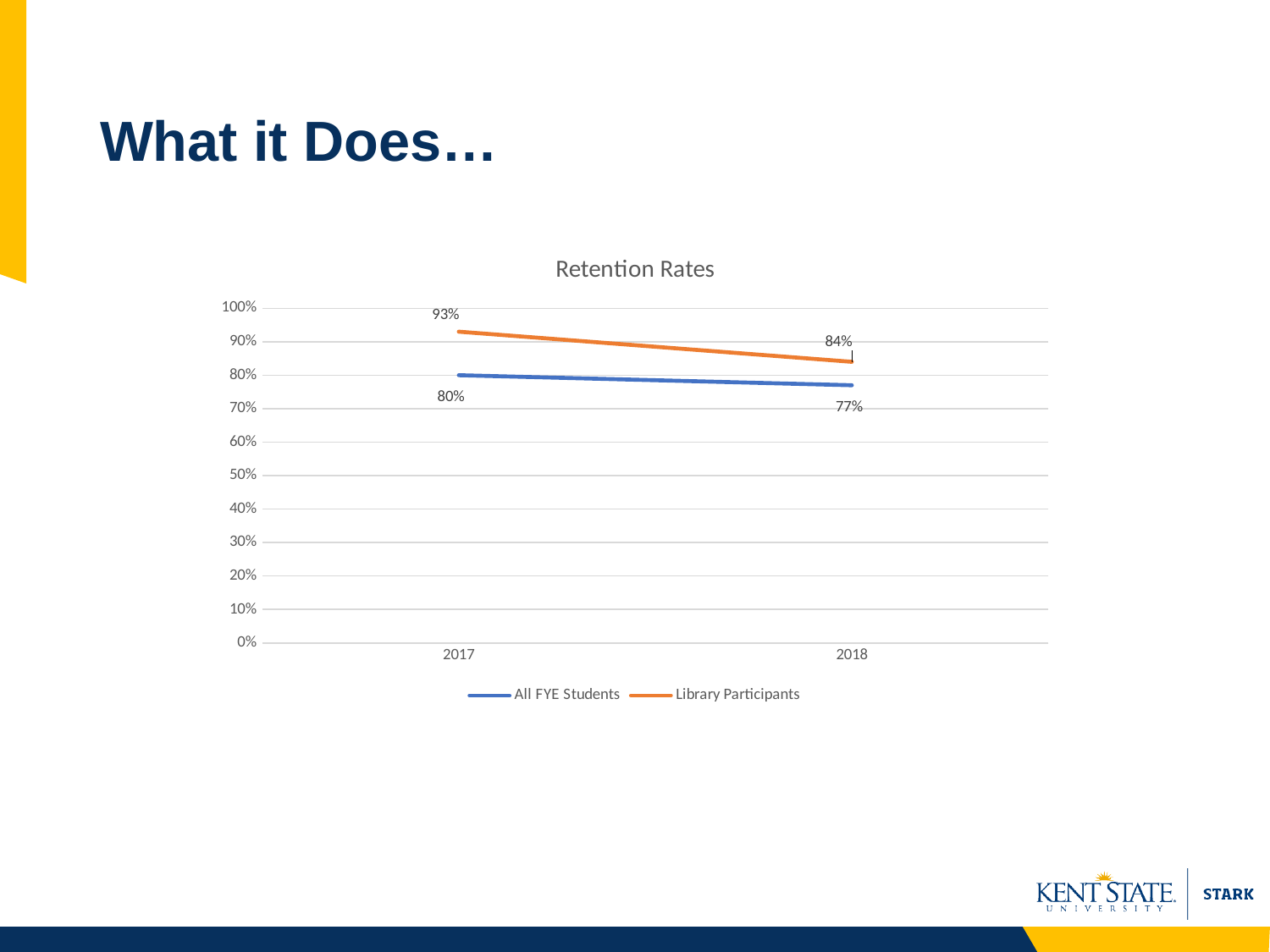
Which series has the higher retention rate in 2018? Library Participants What is the retention rate for All FYE Students in 2017? 80% What is the title of the chart? Retention Rates By how much did the Library Participants retention rate fall from 2017 to 2018? 9% What is the difference between the Library Participants and All FYE Students retention rates in 2017? 13% What is the retention rate for Library Participants in 2018? 84% What kind of chart is shown on the slide? line chart How many series does the legend list? 2 What is the retention rate for Library Participants in 2017? 93% How many years are shown on the x axis? 2 Does the retention rate for All FYE Students rise or fall from 2017 to 2018? fall What is the retention rate for All FYE Students in 2018? 77%